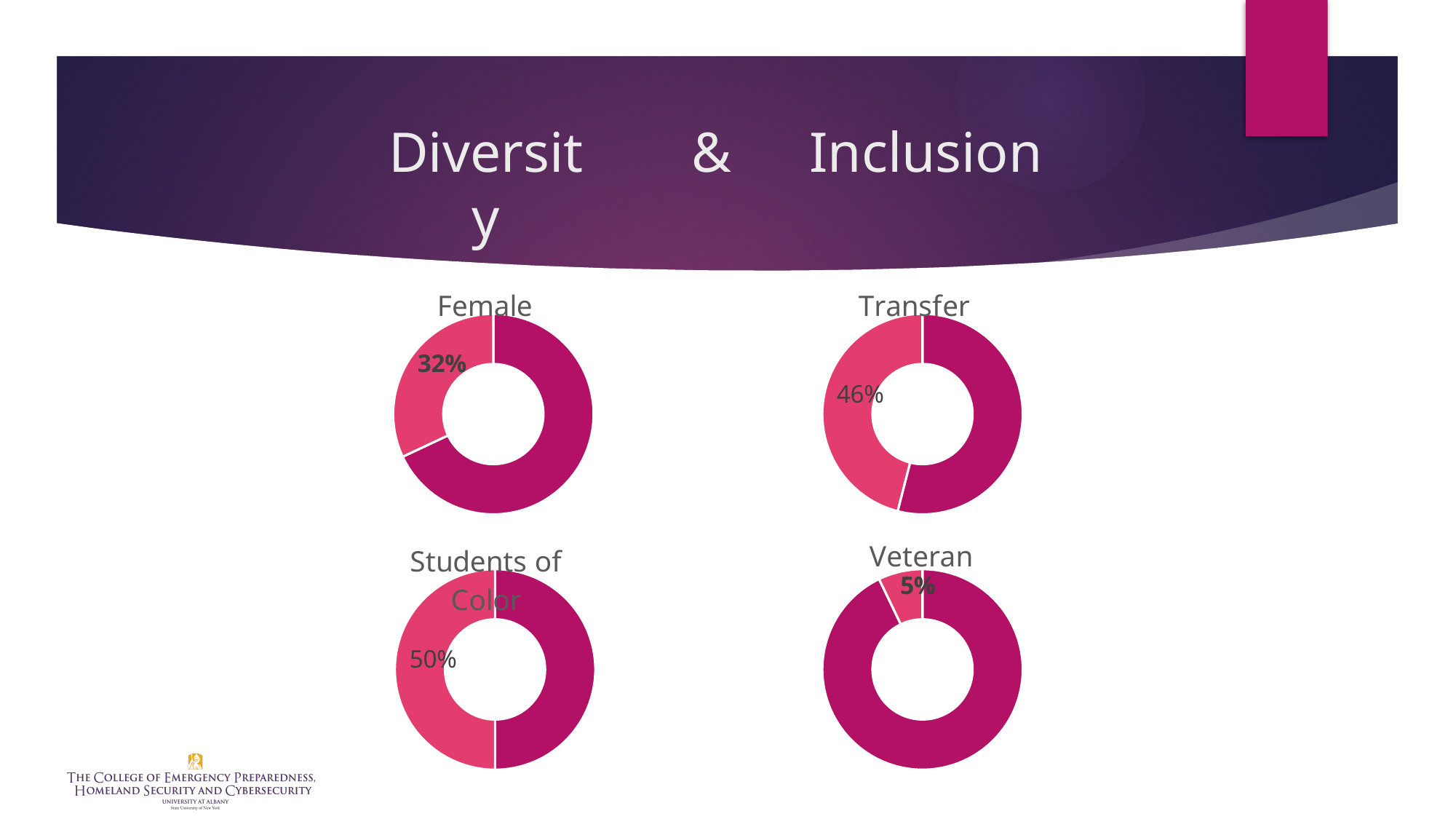
What kind of chart is used for the Veteran data? Doughnut chart Across the four charts, which category has the highest labelled percentage? Students of Color In the Female chart, what percentage is shown for the highlighted slice? 32% In the Students of Color chart, what percentage is shown for the highlighted slice? 50% Which is larger, the Transfer percentage or the Female percentage? Transfer In the Veteran chart, what percentage is shown for the highlighted slice? 5% What is the title of the chart in the bottom-right position of the slide? Veteran What is the difference between the Transfer percentage and the Female percentage? 14 percentage points In the Transfer chart, what percentage is shown for the highlighted slice? 46% Across the four charts, which category has the lowest labelled percentage? Veteran How many doughnut charts are shown on the slide? 4 In the Female chart, is the unlabelled slice greater or less than 50%? greater